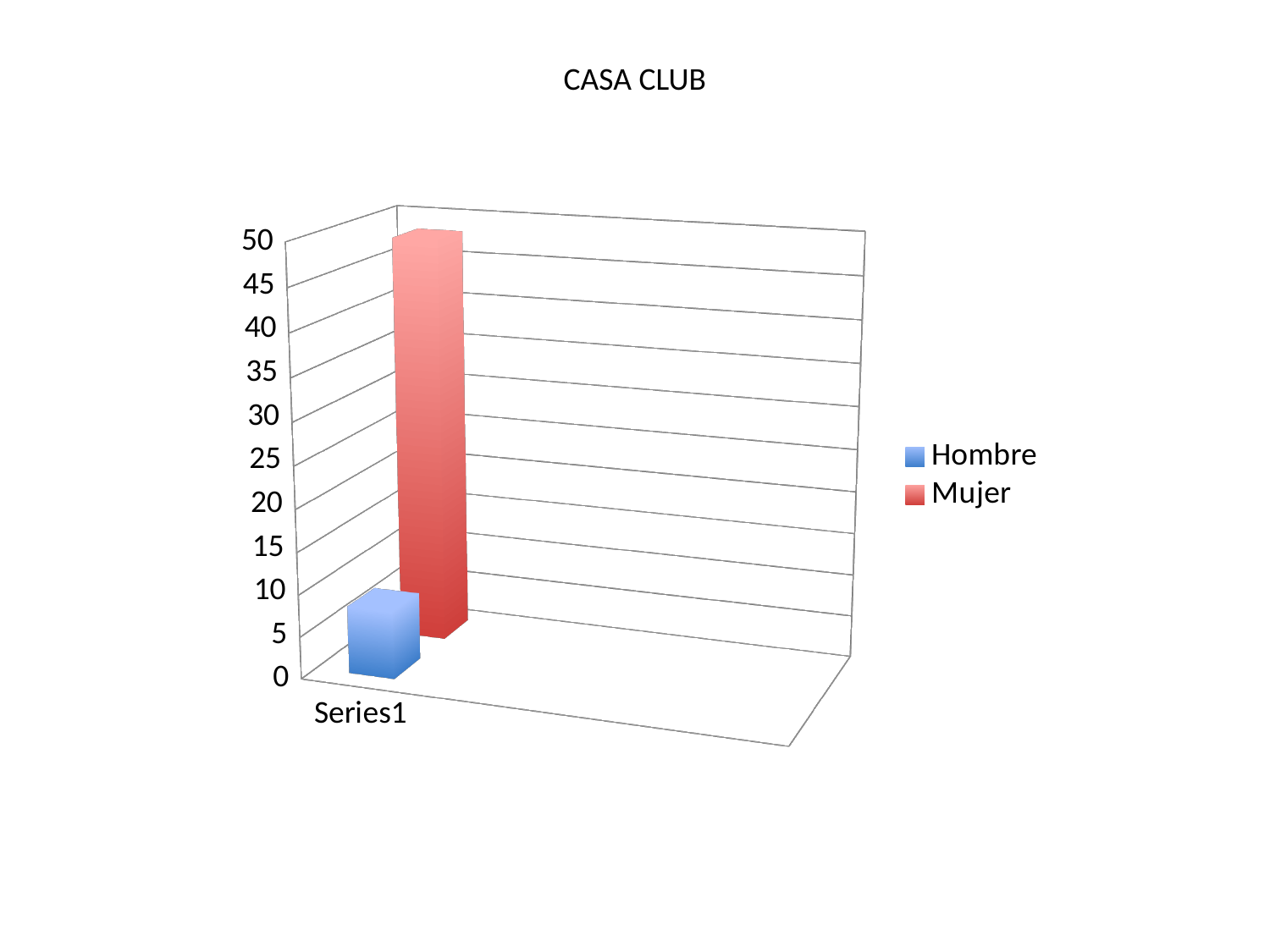
How many categories are shown on the x axis? 1 Which series has the highest value for Series1? Mujer Is the value for Mujer greater or less than 30? greater What colour represents the Mujer series in the legend? red What is the label of the category on the x axis? Series1 What is the title of the chart? CASA CLUB Is the value for Hombre greater or less than 20? less Which is larger for Series1, Hombre or Mujer? Mujer What kind of chart is shown on the slide? bar chart Which series has the lowest value for Series1? Hombre Is the value for Mujer greater or less than 40? greater How many series does the legend list? 2